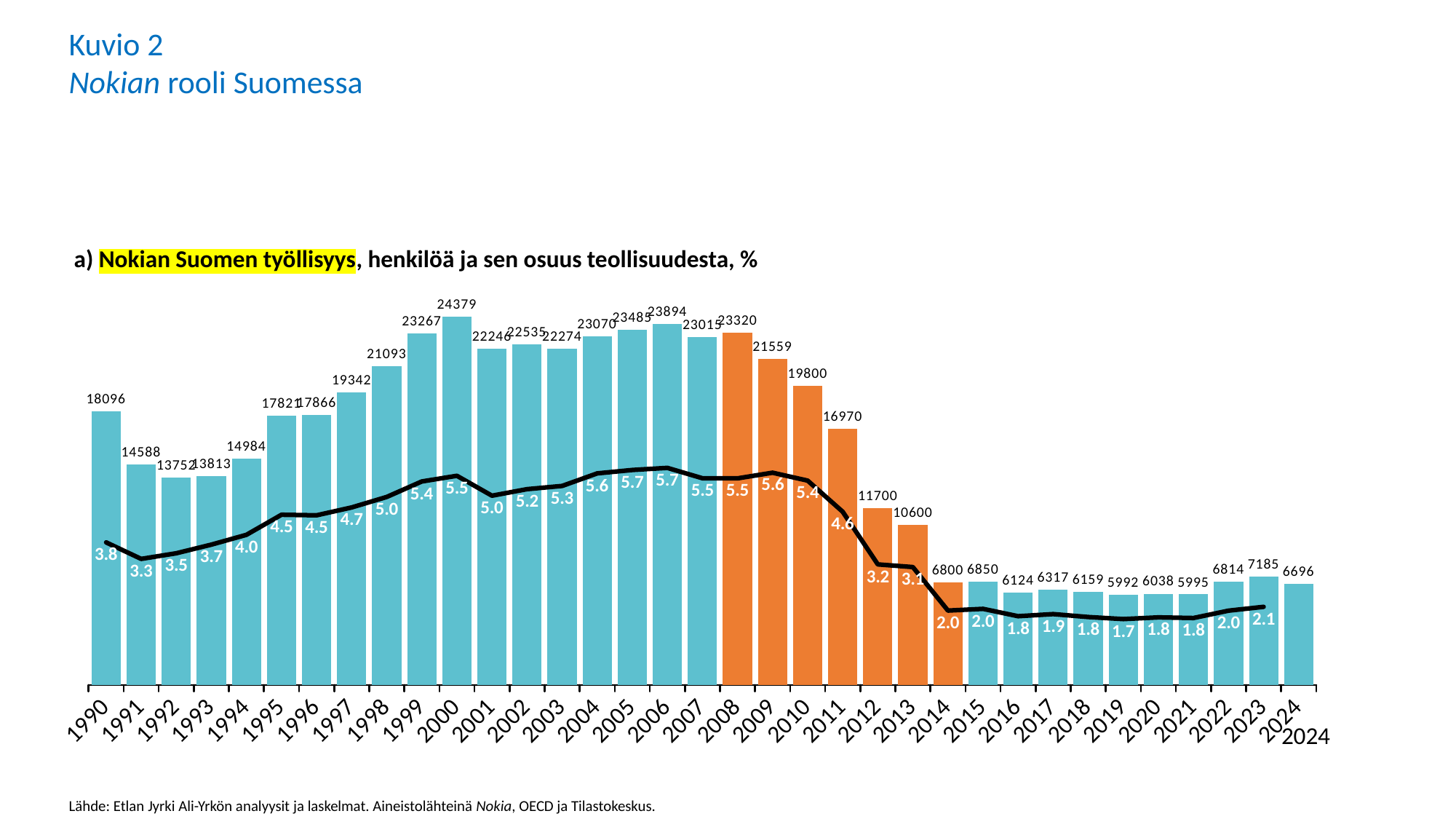
What is the difference between Nokia's employment in 2000 and in 2024? 17683 What was Nokia's employment in Finland in 2024? 6696 How many bars are coloured orange in the chart? 7 How many years (bars) are shown on the x axis of the chart? 35 What is the share of industry (%) shown for 2023? 2.1 What kind of chart is used to show Nokia's employment in Finland? Bar chart with a line overlay Which year has the lowest bar for Nokia's employment in Finland? 2019 What was Nokia's employment in Finland in 2000 according to the bar label? 24379 What share of industry (%) does the line show for 2006? 5.7 Which year has the highest bar for Nokia's employment in Finland? 2000 Do the bars for Nokia's employment rise or fall from 2010 to 2014? Fall Which year had higher Nokia employment in Finland, 2012 or 2013? 2012